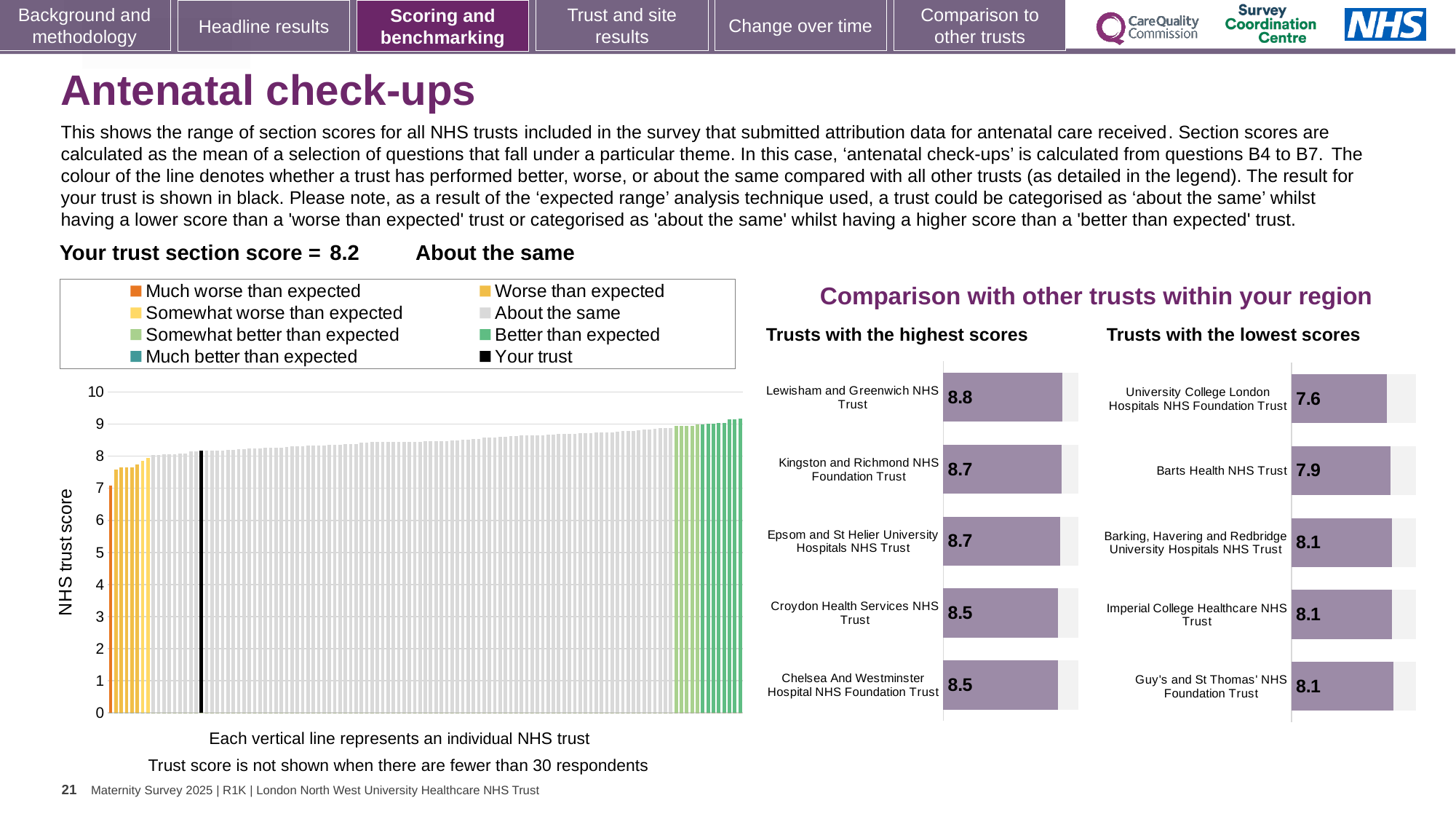
How many trusts are shown in the 'Trusts with the highest scores' chart? 5 In the 'Trusts with the lowest scores' chart, what is the score for University College London Hospitals NHS Foundation Trust? 7.6 In the 'Trusts with the lowest scores' chart, what is the score for Barts Health NHS Trust? 7.9 In the large 'NHS trust score' chart on the left, do the bar heights rise or fall from left to right? Rise In the 'Trusts with the highest scores' chart, what is the difference between the scores of Lewisham and Greenwich NHS Trust and Chelsea And Westminster Hospital NHS Foundation Trust? 0.3 In the 'Trusts with the highest scores' chart, what is the score for Lewisham and Greenwich NHS Trust? 8.8 In the 'Trusts with the lowest scores' chart, which trust has the lowest score? University College London Hospitals NHS Foundation Trust In the 'Trusts with the lowest scores' chart, which has the higher score: Barts Health NHS Trust or University College London Hospitals NHS Foundation Trust? Barts Health NHS Trust In the 'Trusts with the highest scores' chart, what is the score for Croydon Health Services NHS Trust? 8.5 What kind of chart is the large 'NHS trust score' chart on the left? Bar chart In the 'Trusts with the highest scores' chart, which trust has the highest score? Lewisham and Greenwich NHS Trust How many entries does the legend above the large 'NHS trust score' chart list? 8